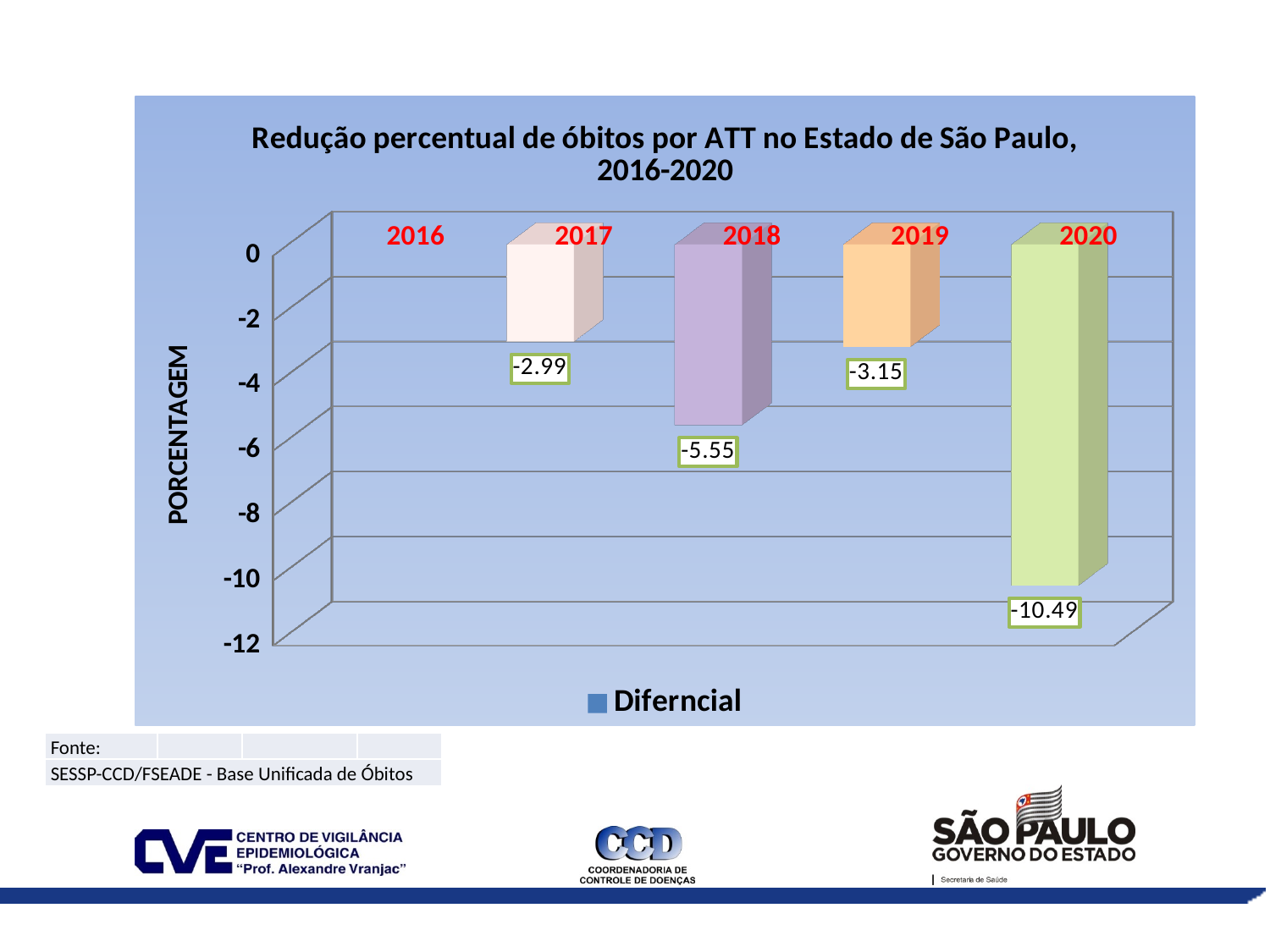
How many years are shown on the x axis? 5 What is the value for 2017? -2.99 What kind of chart is shown? bar chart Which year has the lowest (most negative) value? 2020 What is the difference between the values for 2020 and 2018? 4.94 Is the value for 2020 greater or less than -10? less Which is lower, the value for 2018 or the value for 2019? 2018 How many series does the legend list? 1 Among the years with a labelled bar, which year has the highest value? 2017 What is the value for 2018? -5.55 What is the value for 2020? -10.49 What is the value for 2019? -3.15